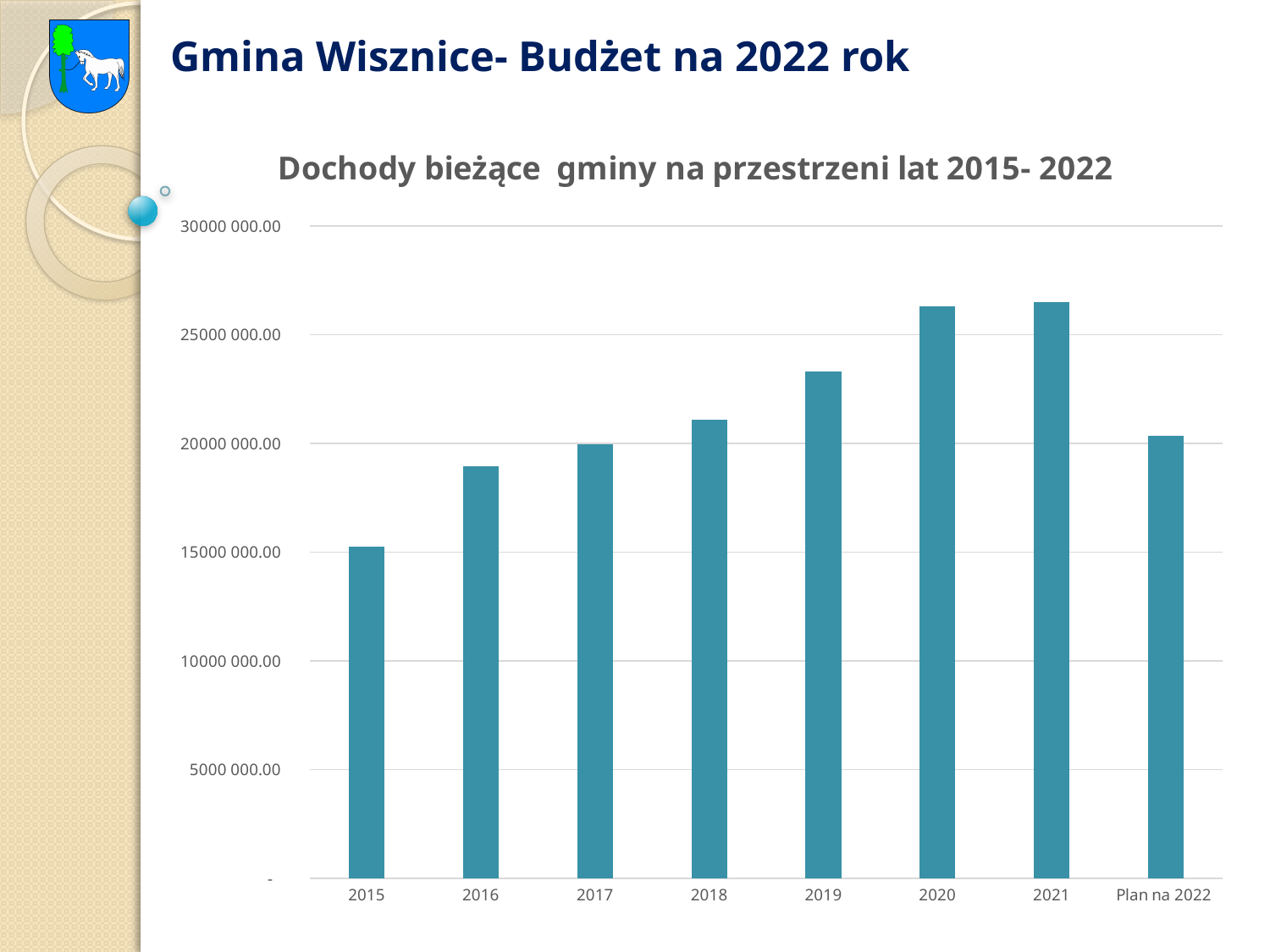
Which is larger, the value for 2016 or the value for 2019? 2019 Is the value for 2021 greater or less than 25000 000.00? greater What kind of chart is shown on the slide? bar chart Is the value for 2015 greater or less than 20000 000.00? less Is the value for 2016 greater or less than 20000 000.00? less What is the title of the chart? Dochody bieżące gminy na przestrzeni lat 2015- 2022 Which category has the lowest value in the chart? 2015 Which is larger, the value for 2020 or the value for Plan na 2022? 2020 How many categories (bars) are shown on the x axis of the chart? 8 Do the values rise or fall from 2015 to 2021? rise